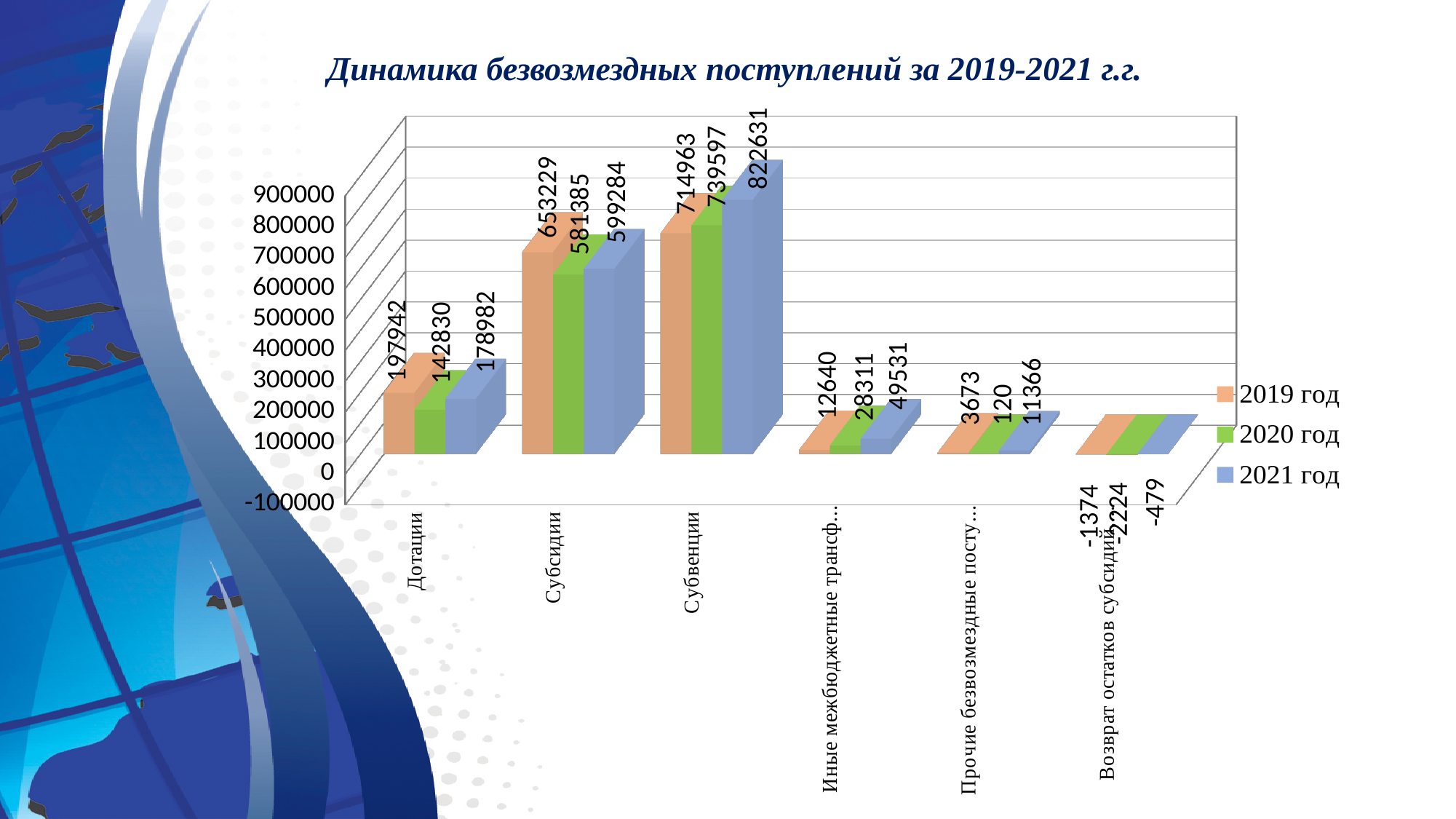
Which category has the lowest value in 2019 год? Возврат остатков субсидий How many series does the legend list? 3 What is the value for Субвенции in 2021 год? 822631 What is the value for Дотации in 2019 год? 197942 What is the value for Возврат остатков субсидий in 2020 год? -2224 Which category has the highest value in 2021 год? Субвенции What is the value for Субсидии in 2020 год? 581385 What is the difference between the 2021 год and 2019 год values for Субвенции? 107668 Which is larger for Субсидии: the 2019 год value or the 2021 год value? 2019 год What is the difference between the 2019 год and 2020 год values for Дотации? 55112 How many categories are shown on the x axis? 6 What kind of chart is shown on the slide? Bar chart